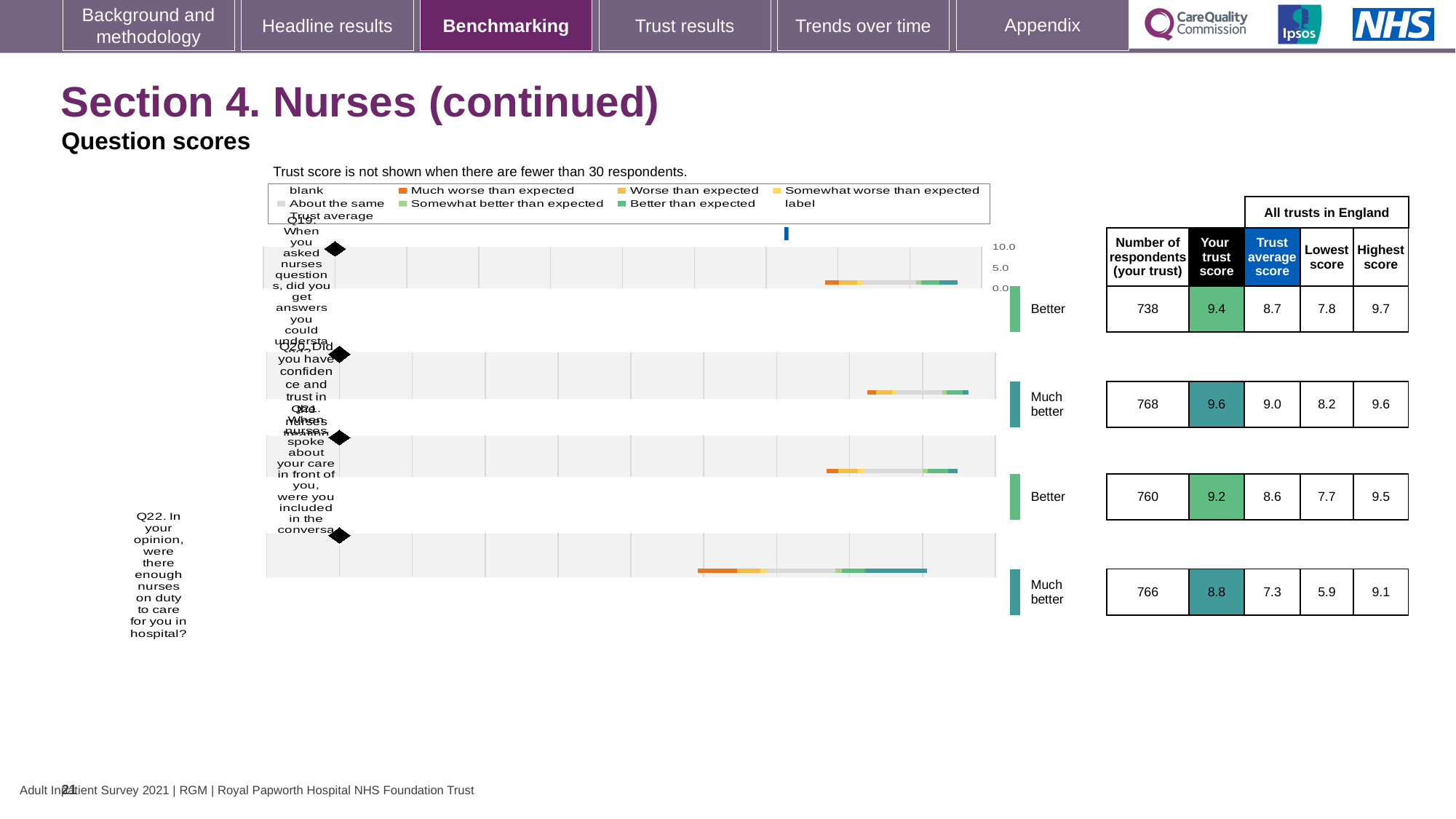
For Q22, what is the difference between your trust score and the trust average score? 1.5 How many questions (categories) are plotted in the chart? 4 What kind of chart is used to show the question scores on this slide? bar chart For Q19, which is larger: your trust score or the trust average score? Your trust score What is the 'Your trust score' value for Q19 (When you asked nurses questions, did you get answers you could understand)? 9.4 What is the lowest score across all trusts in England for Q22? 5.9 What benchmark rating is shown for Q20 (Did you have confidence and trust in the nurses)? Much better Which question has the highest 'Your trust score'? Q20 How many respondents from your trust answered Q22 (were there enough nurses on duty)? 766 Which question has the lowest 'Your trust score'? Q22 What colour does the legend use for 'Much worse than expected'? Orange What is the highest score across all trusts in England for Q21? 9.5